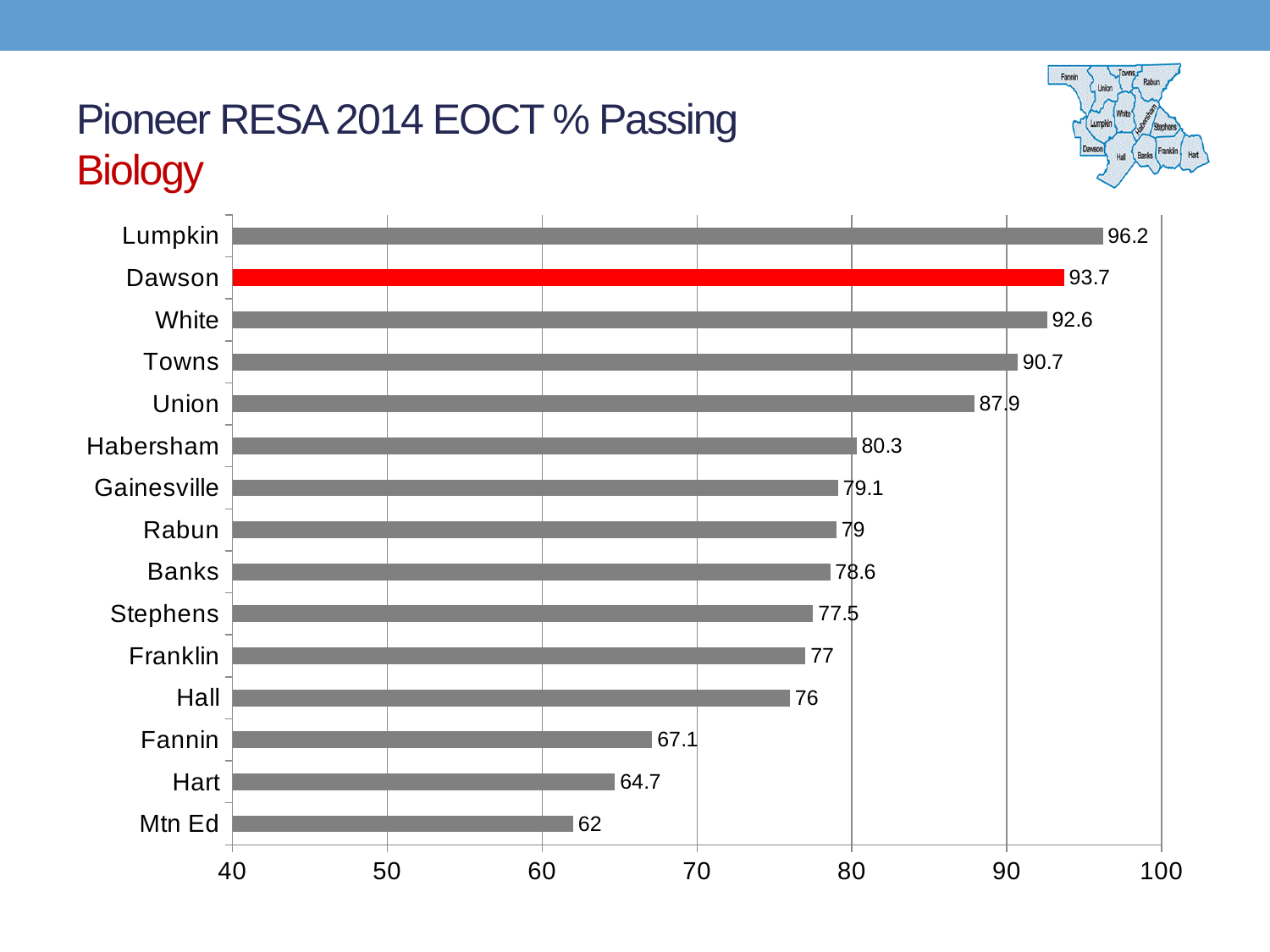
Which is larger, the value for Union or the value for Habersham? Union What is the value for Habersham? 80.3 What is the value for Dawson? 93.7 Which category's bar is coloured red? Dawson Which category has the highest value? Lumpkin What is the value for Hart? 64.7 Is the value for Fannin greater or less than 70? less What is the difference between the values for Lumpkin and Mtn Ed? 34.2 What kind of chart is shown on the slide? bar chart What is the difference between the values for Dawson and White? 1.1 Which category has the lowest value? Mtn Ed How many categories are shown on the chart? 15